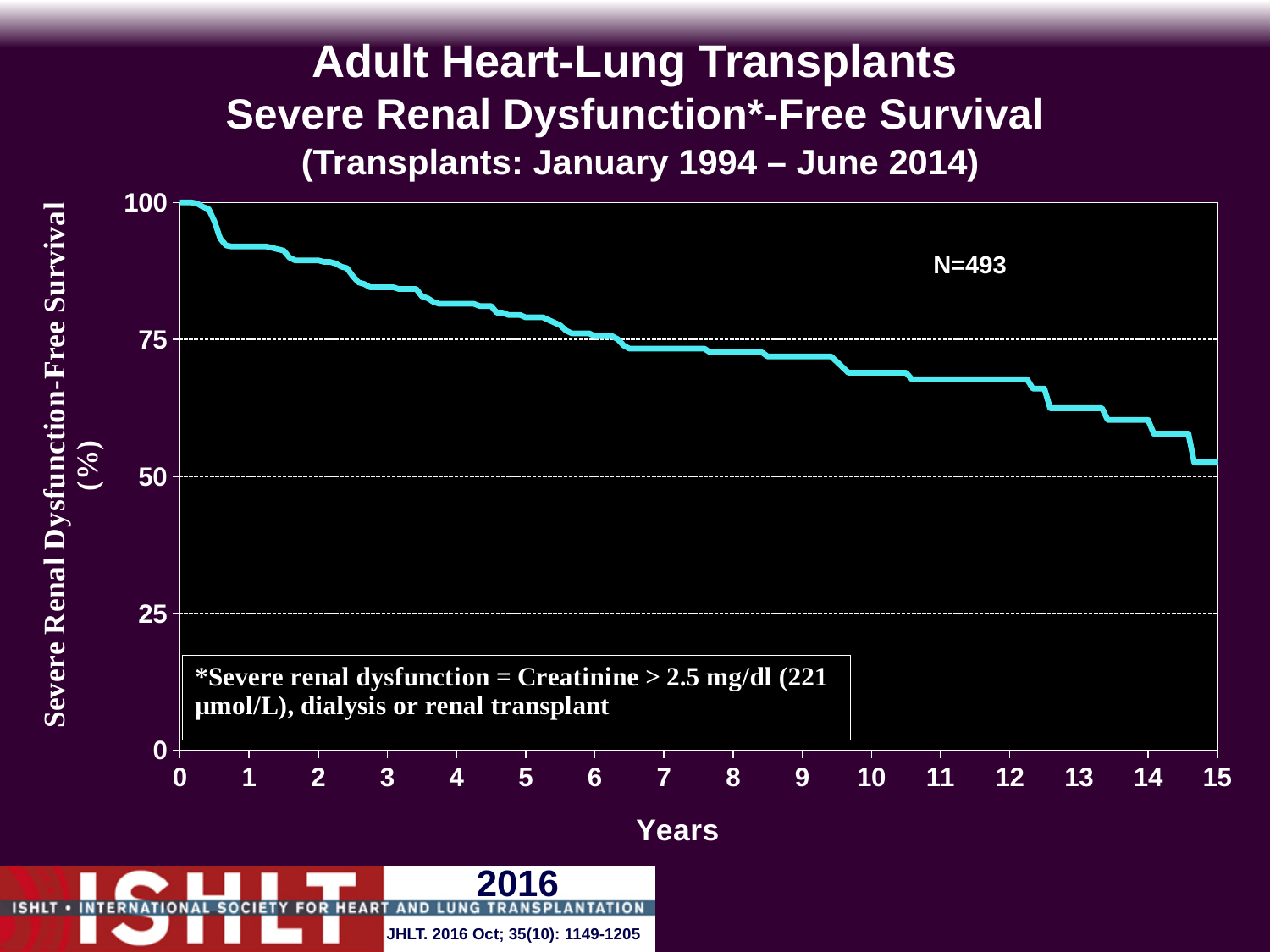
Is the severe renal dysfunction-free survival at year 1 greater or less than 75? greater What kind of chart is shown on the slide? line chart Does the severe renal dysfunction-free survival curve rise or fall as years increase? fall Is the severe renal dysfunction-free survival at year 5 greater or less than 75? greater Is the severe renal dysfunction-free survival at year 10 greater or less than 75? less What is the severe renal dysfunction-free survival value at year 0? 100 What is the label of the x axis? Years How many survival curves are plotted on the chart? 1 What is the sample size (N) shown on the chart? N=493 Is the survival value at year 3 larger or smaller than the value at year 12? larger